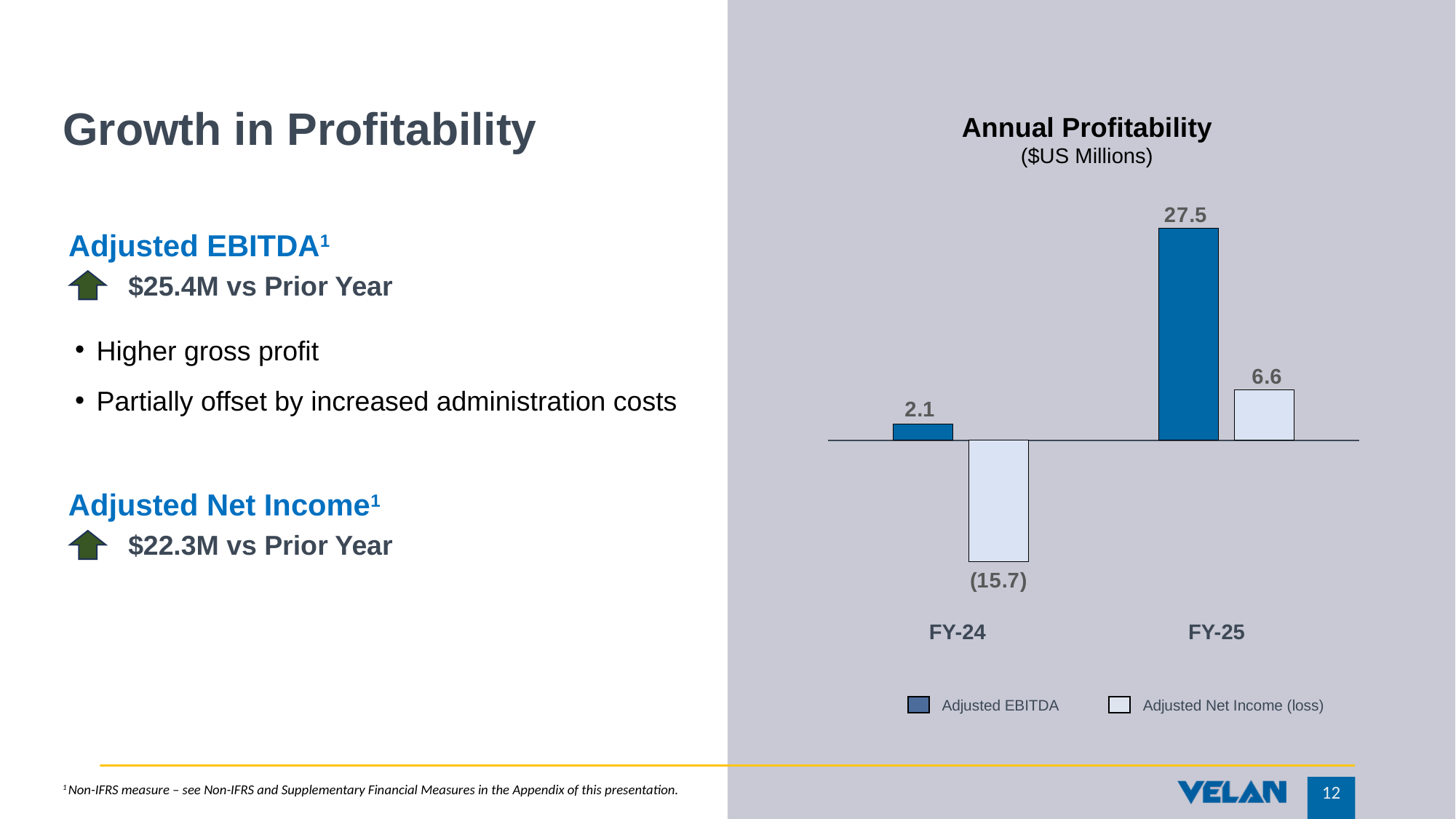
Is Adjusted EBITDA or Adjusted Net Income (loss) larger in FY-25? Adjusted EBITDA What is the Adjusted EBITDA value for FY-24? 2.1 Which bar shows the lowest value on the chart? Adjusted Net Income (loss) for FY-24 Which year has the higher Adjusted EBITDA? FY-25 How many series does the chart legend list? 2 What kind of chart is shown on the slide? Bar chart What is the difference between Adjusted EBITDA in FY-25 and FY-24? 25.4 What unit is stated under the chart title? $US Millions How many years are shown on the x axis of the chart? 2 What is the Adjusted Net Income (loss) value for FY-24? (15.7) What is the Adjusted Net Income (loss) value for FY-25? 6.6 What is the Adjusted EBITDA value for FY-25? 27.5